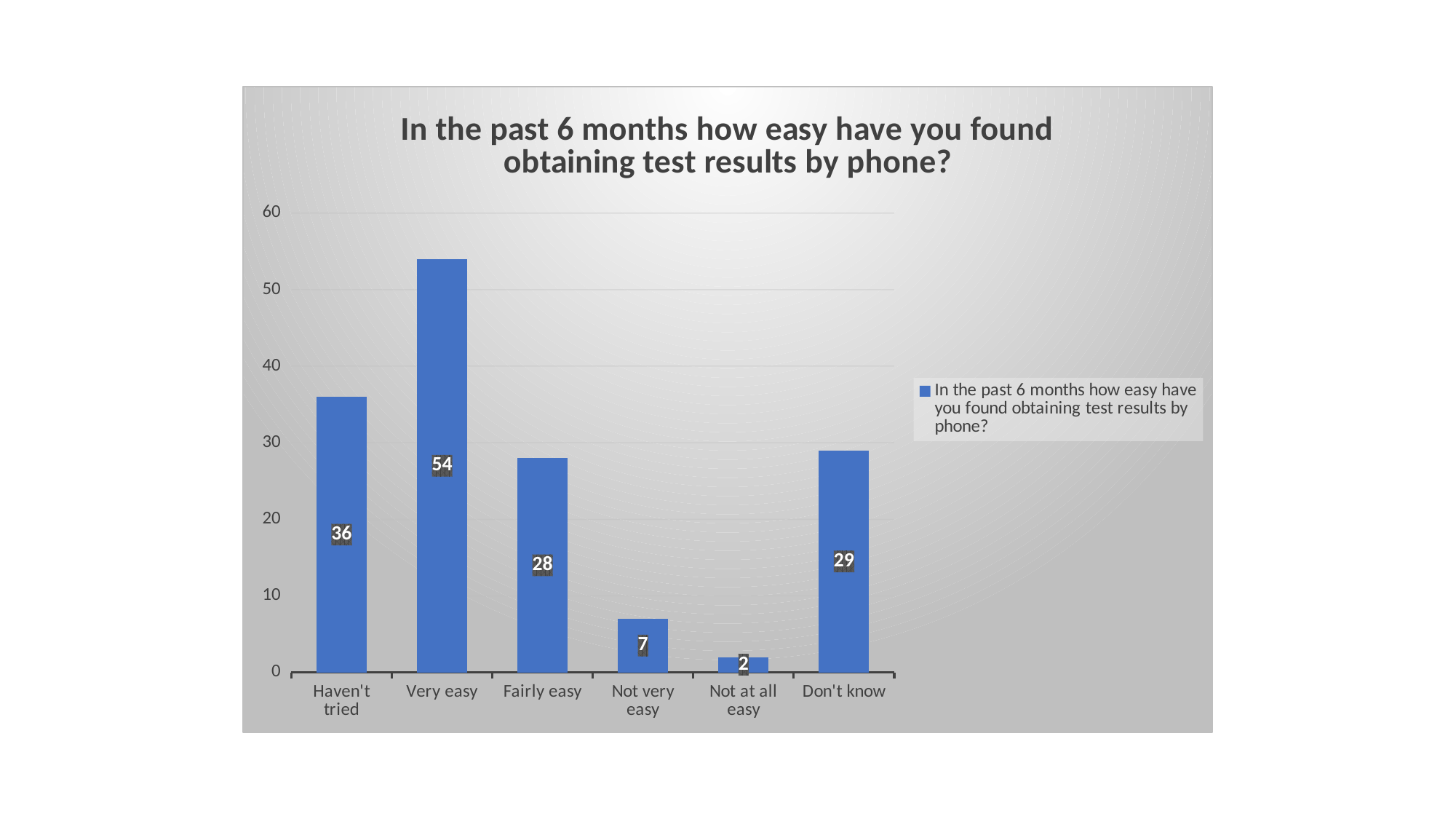
What kind of chart is shown on the slide? bar chart What is the value for "Very easy"? 54 What is the difference between the values for "Very easy" and "Fairly easy"? 26 Which category has the lowest value? Not at all easy What is the value for "Not at all easy"? 2 What is the title of the chart? In the past 6 months how easy have you found obtaining test results by phone? How many series does the legend list? 1 Is the value for "Very easy" greater or less than 50? greater How many categories are shown on the x axis? 6 Which is larger, the value for "Haven't tried" or the value for "Don't know"? Haven't tried Which category has the highest value? Very easy What is the value for "Haven't tried"? 36